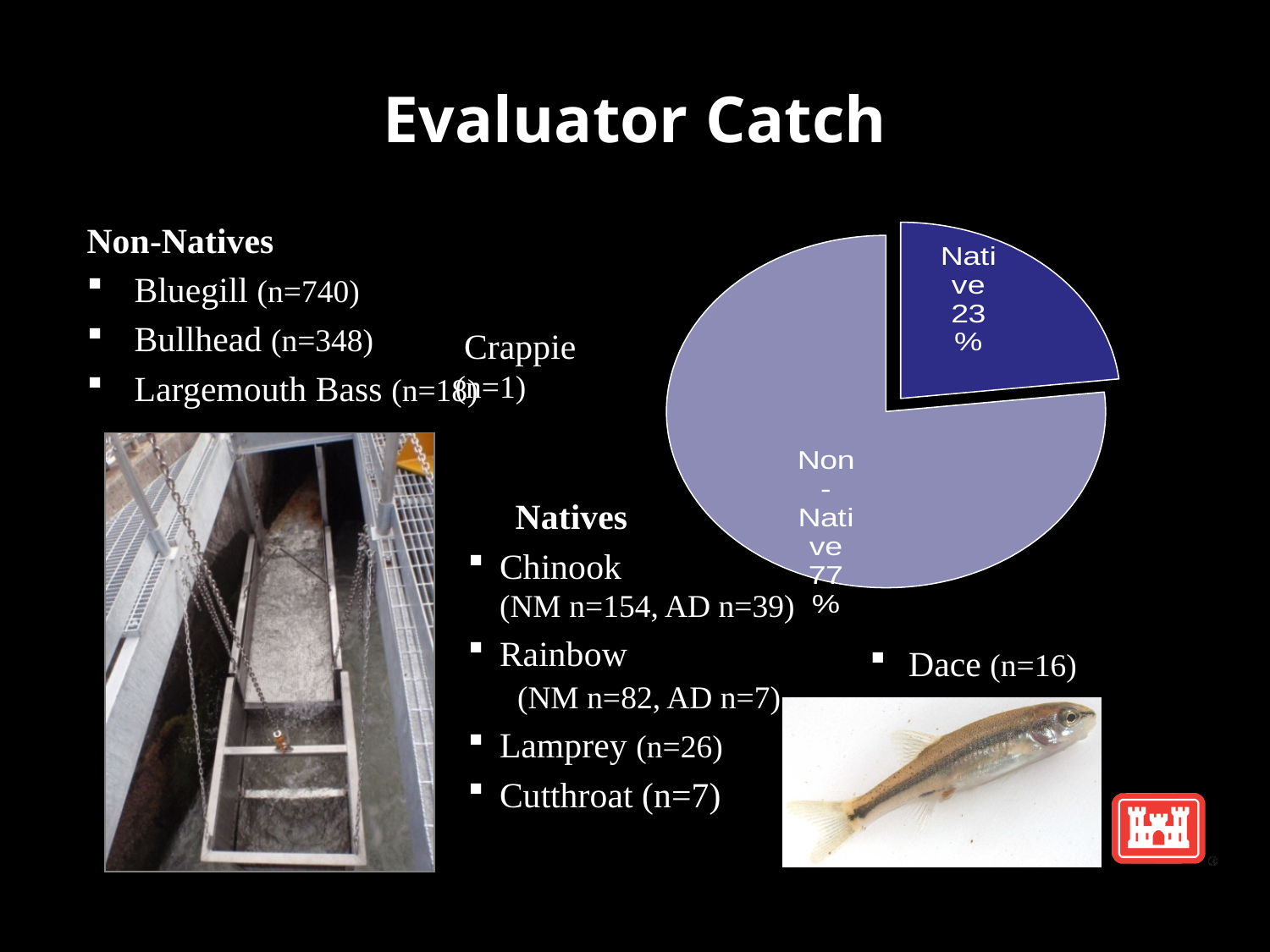
Which slice of the pie chart is the largest? Non-Native What share of the pie chart is labelled Non-Native? 77% What share of the pie chart is labelled Native? 23% Which slice of the pie chart is the smallest? Native How many slices does the pie chart have? 2 What is the difference in percentage points between the Non-Native and Native slices of the pie chart? 54 What kind of chart is shown on the slide? pie chart Which is larger in the pie chart, the Native slice or the Non-Native slice? Non-Native Which slice of the pie chart is pulled out (exploded) from the rest of the pie? Native Which slice of the pie chart is drawn in the darker blue colour? Native What do the two slices of the pie chart add up to? 100%